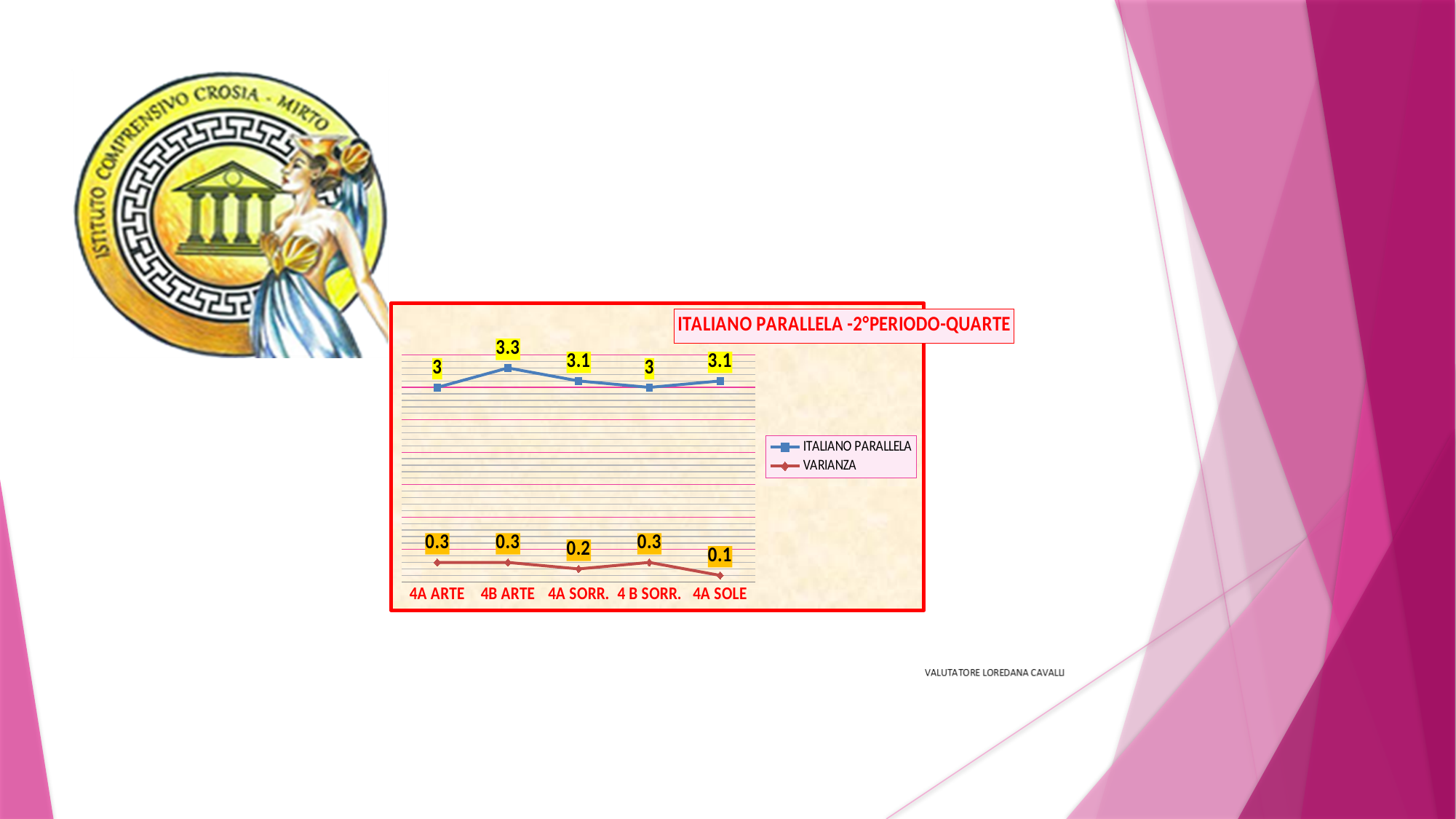
What is the title of the chart? ITALIANO PARALLELA -2°PERIODO-QUARTE What is the ITALIANO PARALLELA value for 4B ARTE? 3.3 What kind of chart is shown? Line chart How many categories are shown on the x axis? 5 Which is larger, the ITALIANO PARALLELA value for 4A SORR. or for 4 B SORR.? 4A SORR. What is the ITALIANO PARALLELA value for 4A SORR.? 3.1 Which category has the lowest VARIANZA value? 4A SOLE What is the difference between the ITALIANO PARALLELA values for 4B ARTE and 4A ARTE? 0.3 Which category has the highest ITALIANO PARALLELA value? 4B ARTE What is the VARIANZA value for 4A SORR.? 0.2 How many series does the legend list? 2 What is the VARIANZA value for 4A SOLE? 0.1